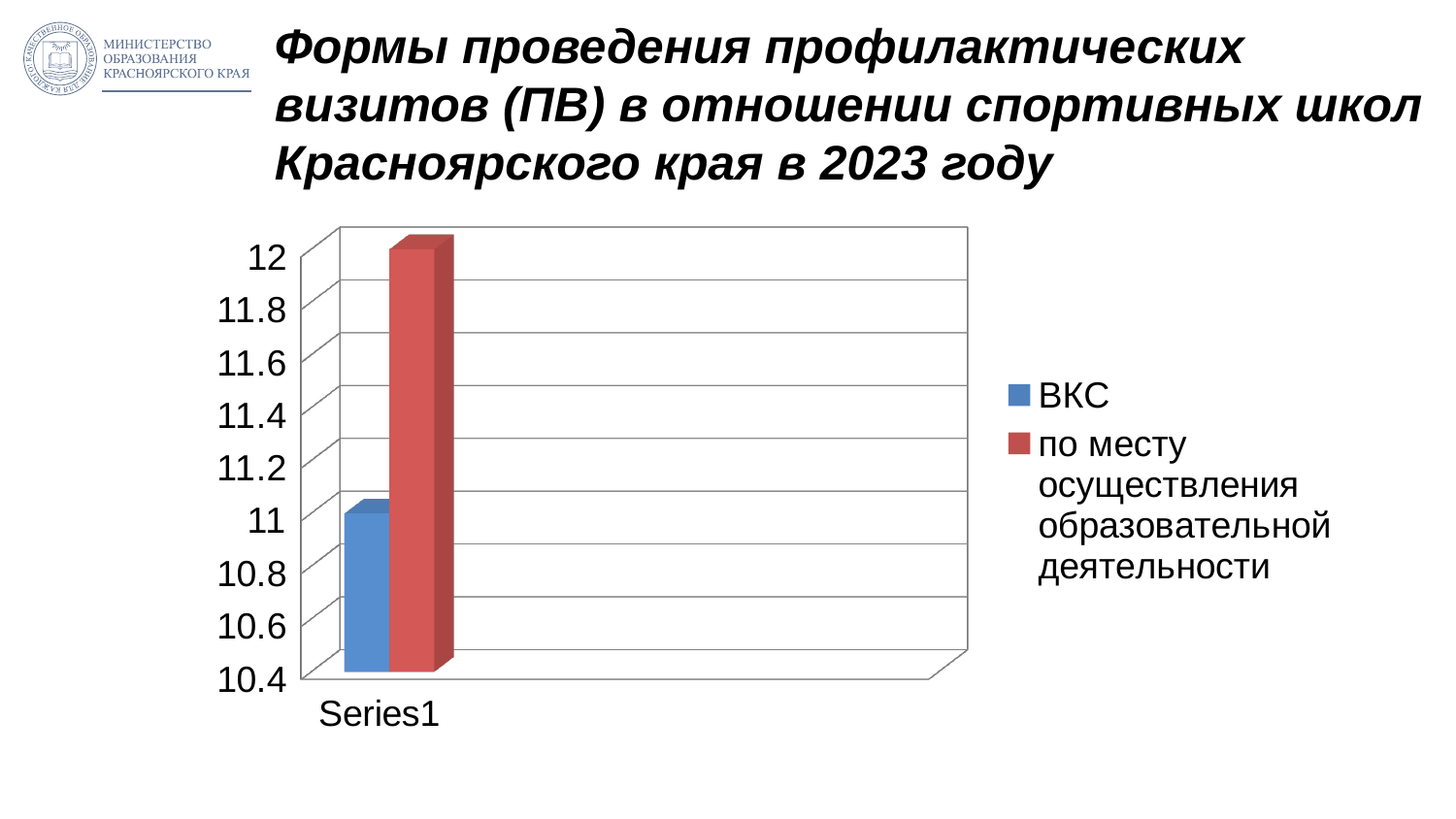
What colour is the bar for ВКС? blue Is the value for ВКС greater or less than 11.4? less What is the value of the ВКС bar? 11 Is the value for 'по месту осуществления образовательной деятельности' greater or less than 11.6? greater What is the difference between the value for 'по месту осуществления образовательной деятельности' and the value for ВКС? 1 How many categories are shown on the x axis? 1 What is the value of the bar for 'по месту осуществления образовательной деятельности'? 12 What is the label of the category on the x axis? Series1 Which series has the higher value? по месту осуществления образовательной деятельности What kind of chart is shown on the slide? bar chart Which series has the lower value? ВКС How many series does the legend list? 2